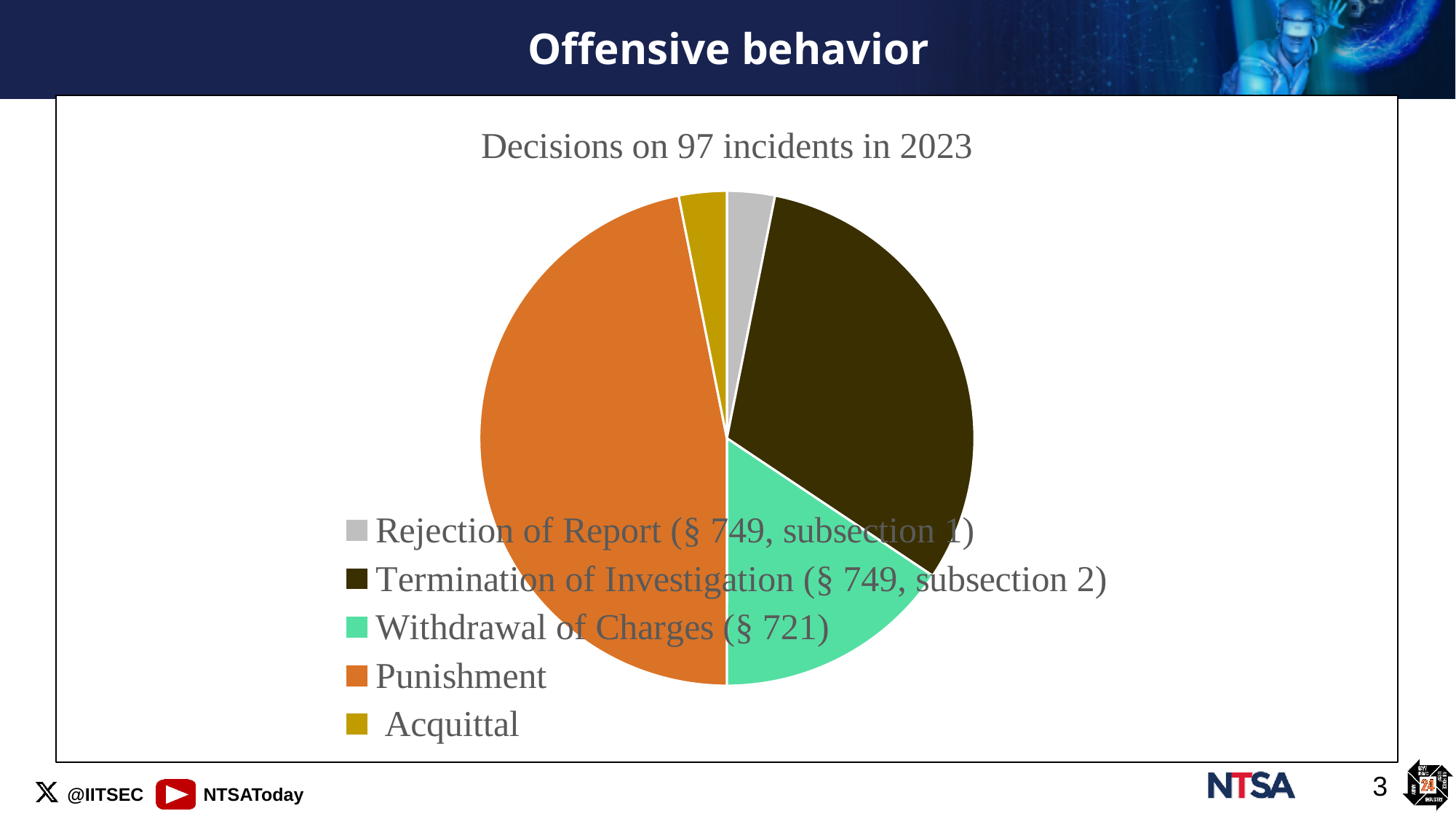
Which slice is larger: Punishment or Termination of Investigation (§ 749, subsection 2)? Punishment Which category has the largest slice of the pie? Punishment How many categories does the pie chart's legend list? 5 Which slice is larger: Withdrawal of Charges (§ 721) or Acquittal? Withdrawal of Charges (§ 721) How many incidents does the chart title say decisions were made on in 2023? 97 Which slice is larger: Termination of Investigation (§ 749, subsection 2) or Rejection of Report (§ 749, subsection 1)? Termination of Investigation (§ 749, subsection 2) What kind of chart is shown on the slide? pie chart Which colour represents Punishment in the pie chart? orange What is the title of the chart? Decisions on 97 incidents in 2023